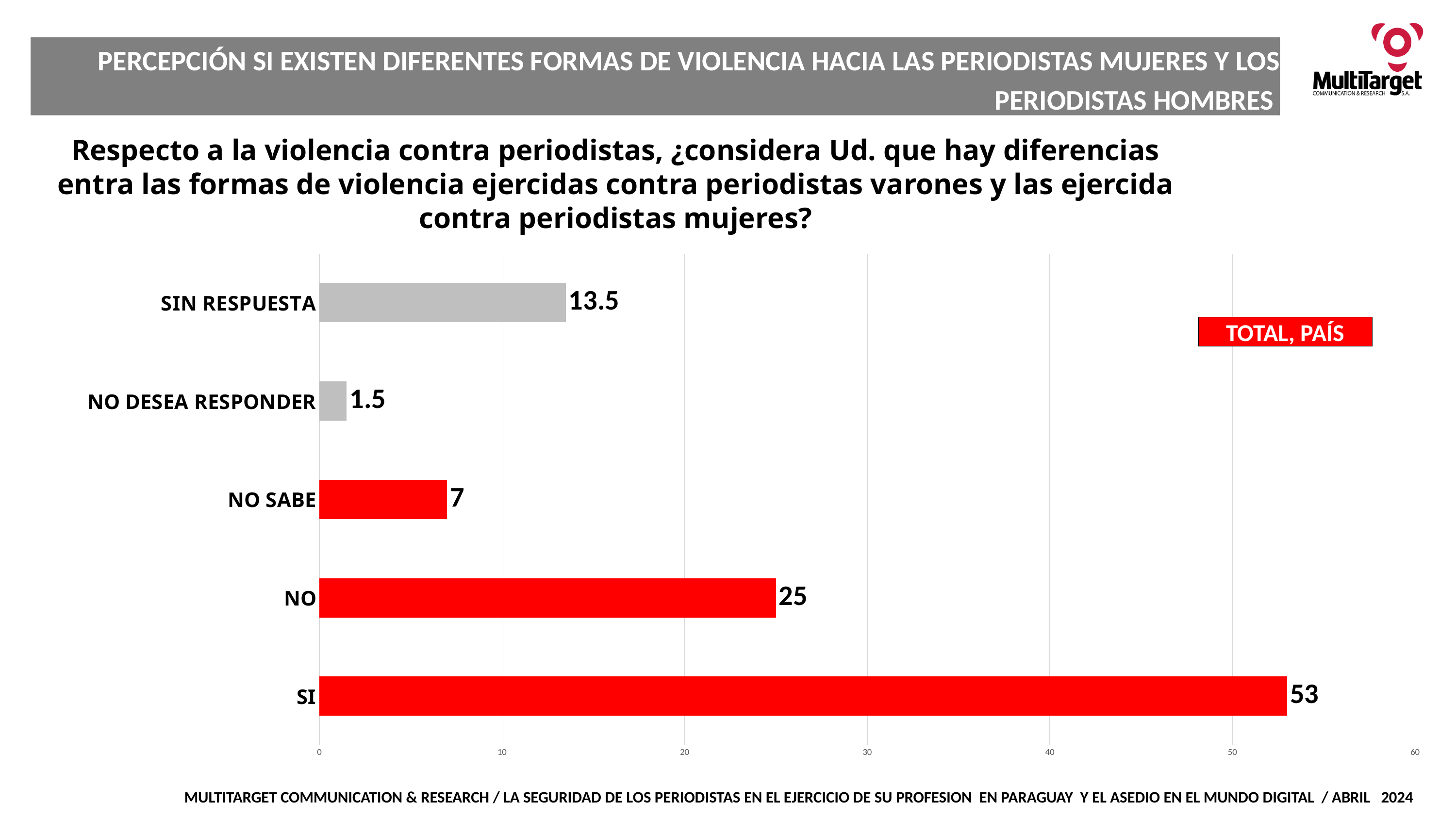
Which category has the highest value? SI What is the value for NO DESEA RESPONDER? 1.5 What does the red label box to the right of the chart say? TOTAL, PAÍS Is the value for NO greater or less than 20? greater What is the difference between the values for SI and NO? 28 How many categories are shown in the chart? 5 Which category has the lowest value? NO DESEA RESPONDER What is the value for SI? 53 Which is larger, the value for NO or the value for SIN RESPUESTA? NO What is the difference between the values for SIN RESPUESTA and NO SABE? 6.5 What kind of chart is shown on the slide? bar chart What is the value for SIN RESPUESTA? 13.5